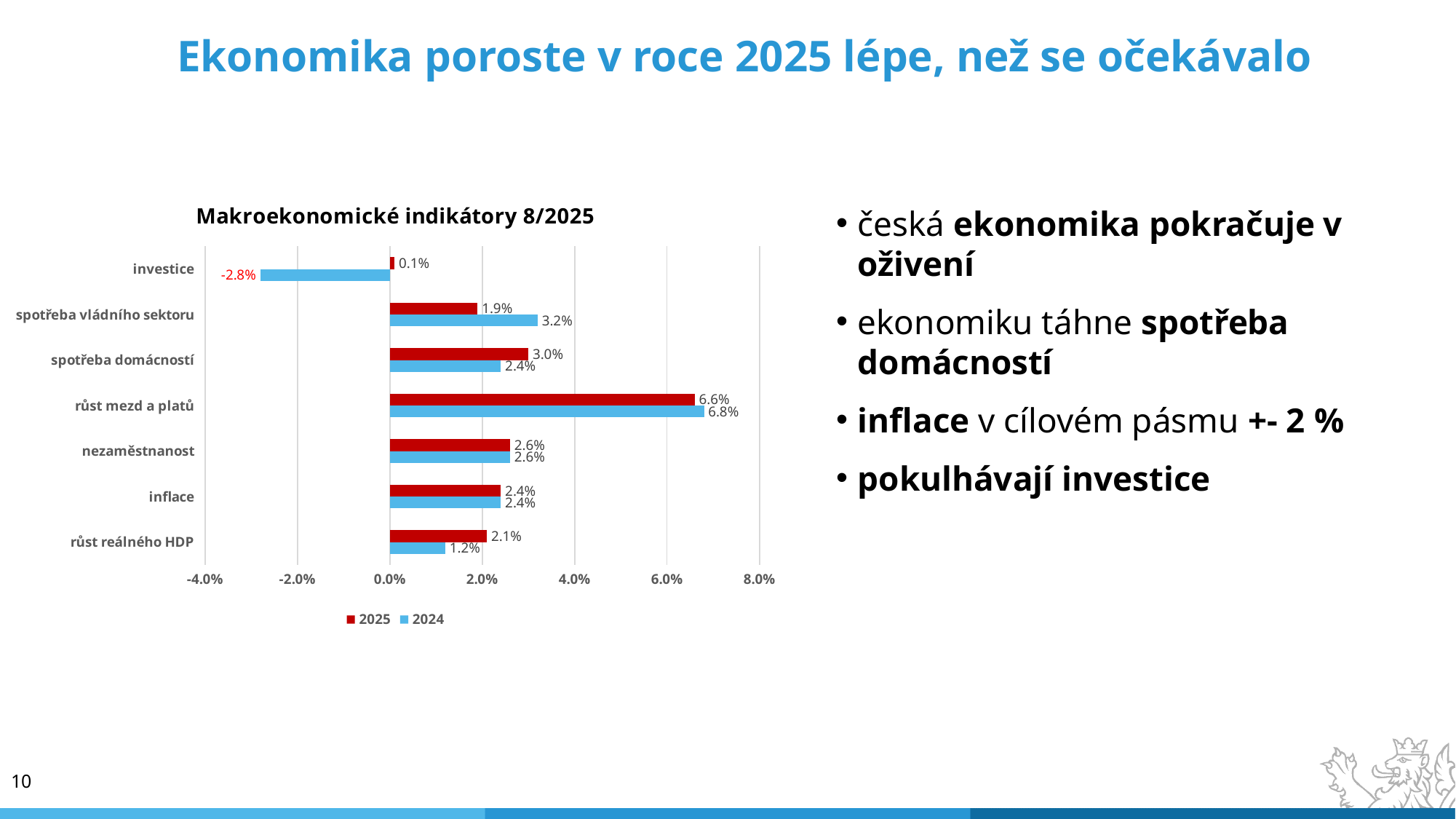
What is the title of the chart? Makroekonomické indikátory 8/2025 What is the 2024 value for spotřeba vládního sektoru? 3.2% What is the 2025 value for spotřeba domácností? 3.0% What is the difference between the 2024 and 2025 values for růst reálného HDP? 0.9% What is the 2025 value for růst reálného HDP? 2.1% Which category has the lowest 2024 value? investice How many series does the legend list? 2 Which is larger for spotřeba vládního sektoru, the 2025 value or the 2024 value? 2024 Which category has the highest 2025 value? růst mezd a platů What is the 2024 value for investice? -2.8% How many categories are shown on the chart? 7 What kind of chart is shown on the slide? bar chart